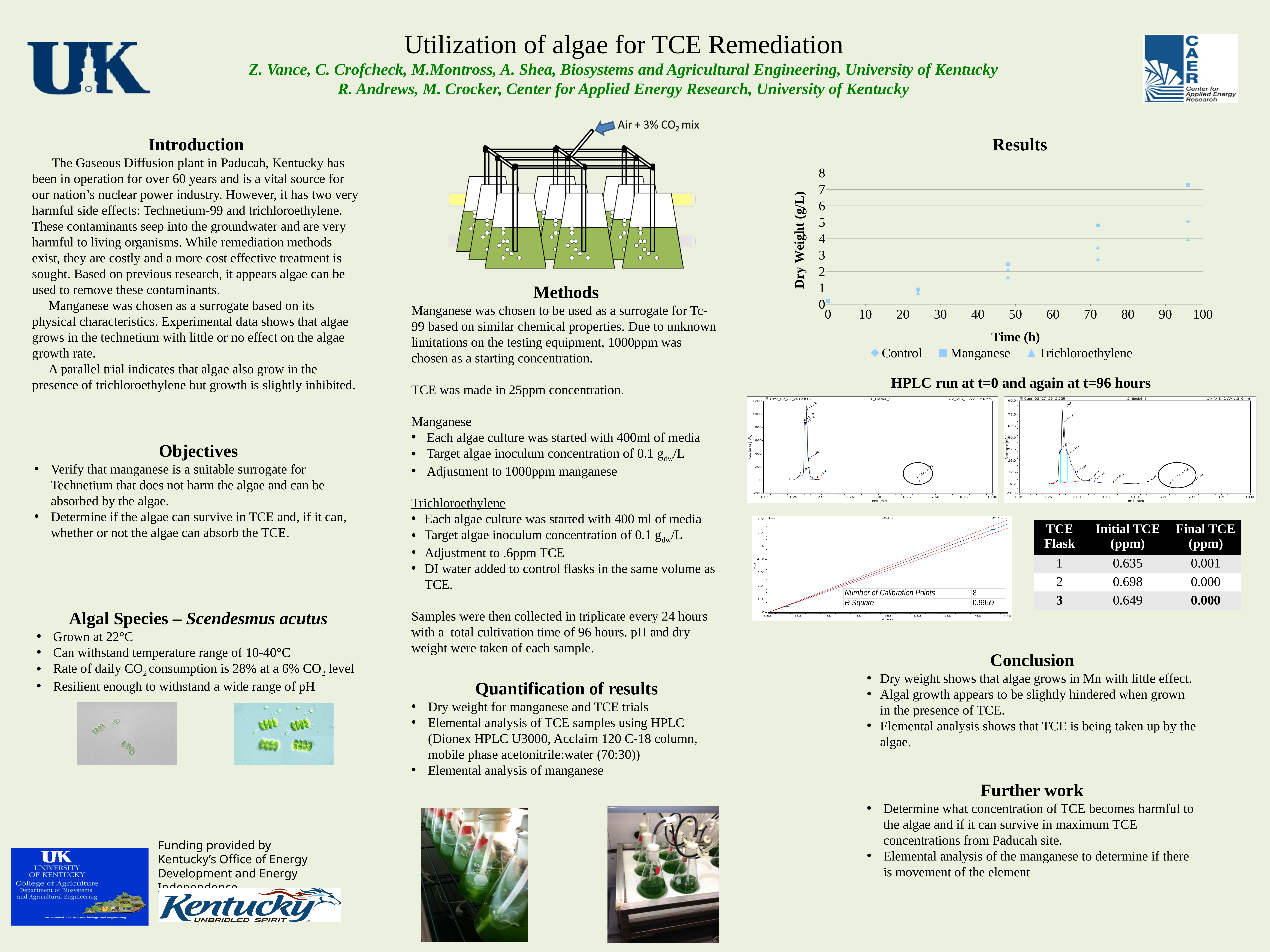
In the Results chart, is the Manganese dry weight at 72 h greater or less than 4? greater In the Results chart, is the Control dry weight at 96 h greater or less than 4? greater In the Results chart, which series has the highest dry weight at 96 h? Manganese In the Results chart, which series has the lowest dry weight at 96 h? Trichloroethylene How many series does the legend of the Results chart list? 3 What are the three series named in the legend of the Results chart? Control, Manganese, Trichloroethylene In the Results chart, is the Manganese dry weight at 96 h greater or less than 6? greater In the Results chart, does the dry weight rise or fall as time increases? rise What is the y-axis title of the Results chart? Dry Weight (g/L) In the Results chart, at 96 h, which is larger: the Manganese dry weight or the Trichloroethylene dry weight? Manganese What kind of chart is the Results chart? scatter chart